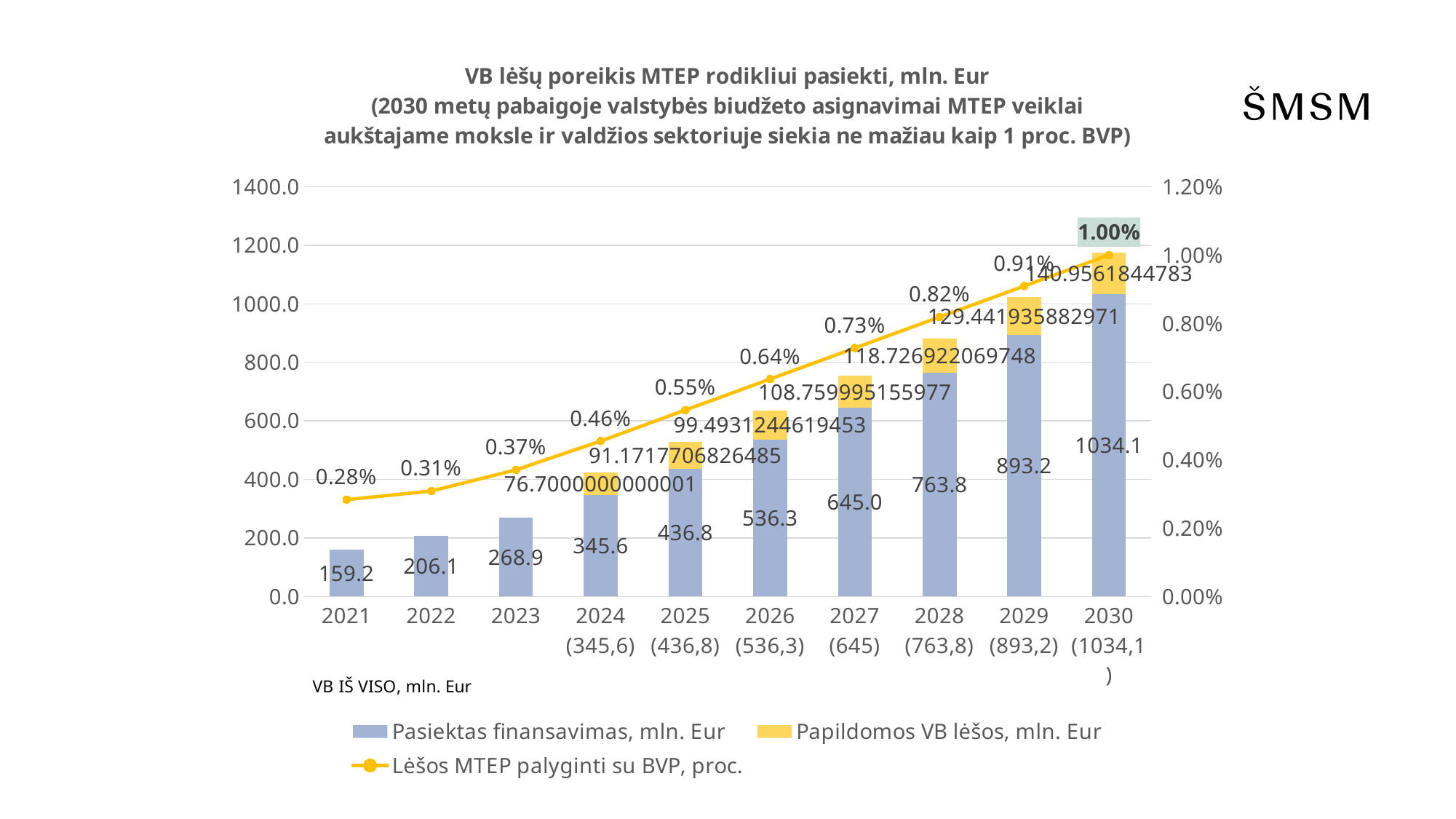
Does 'Lėšos MTEP palyginti su BVP, proc.' rise or fall from 2021 to 2030? rise Is the total height of the stacked bar for 2030 greater or less than 1000.0? greater What is the value of 'Pasiektas finansavimas, mln. Eur' for 2021? 159.2 Which is larger: 'Pasiektas finansavimas, mln. Eur' in 2027 or in 2025? 2027 What is the value of 'Lėšos MTEP palyginti su BVP, proc.' for 2026? 0.64% How many years are shown on the x axis? 10 In which year is 'Lėšos MTEP palyginti su BVP, proc.' highest? 2030 In which year is 'Pasiektas finansavimas, mln. Eur' lowest? 2021 What is the difference between 'Pasiektas finansavimas, mln. Eur' in 2030 and in 2021? 874.9 What is the value of 'Papildomos VB lėšos, mln. Eur' for 2024? 76.7000000000001 How many series does the legend list? 3 What is the value of 'Pasiektas finansavimas, mln. Eur' for 2030? 1034.1